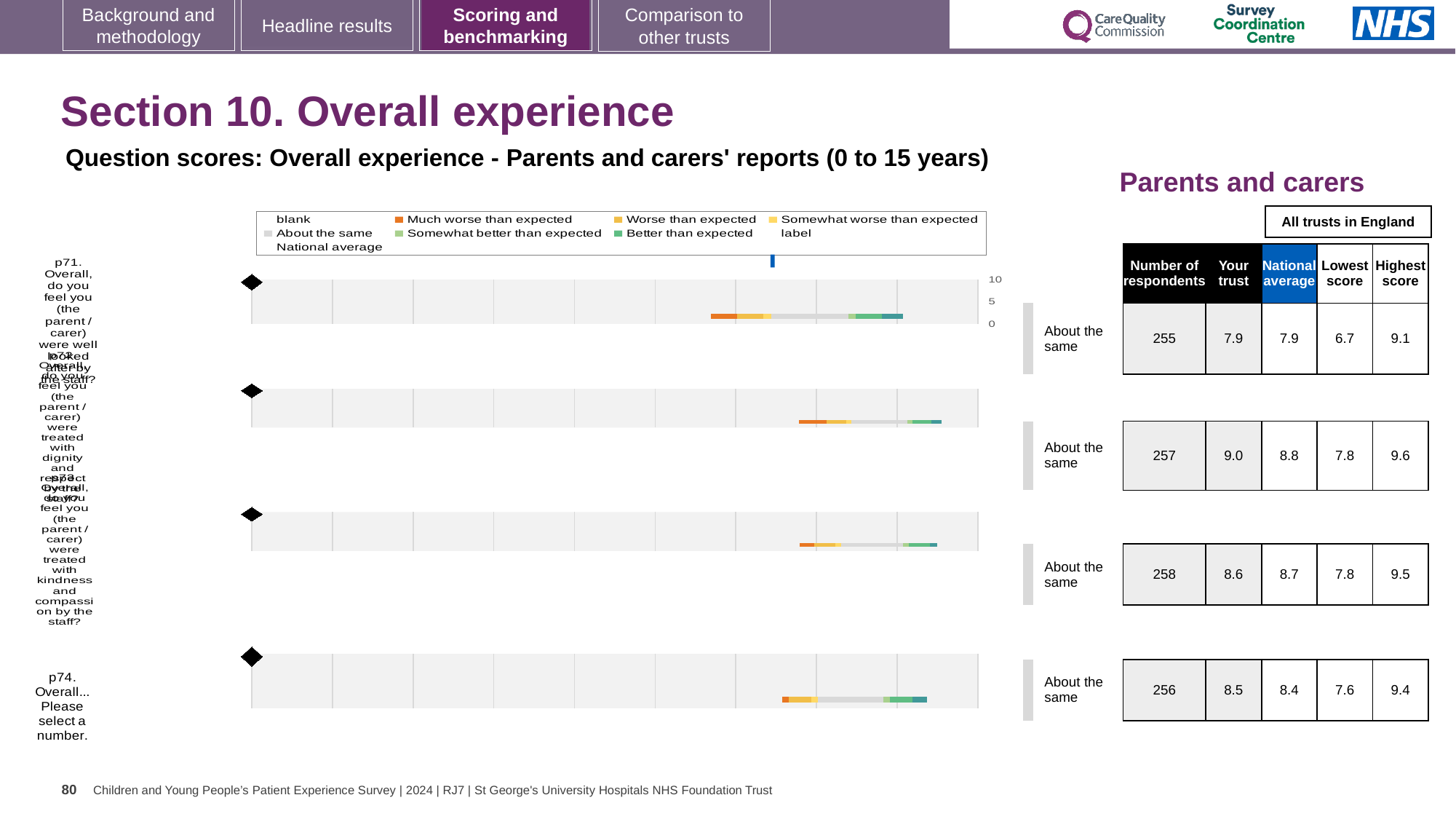
What is the highest score across all trusts in England for p74 (the bottom row)? 9.4 How many respondents are listed for p73 (the third row)? 258 What is the lowest score across all trusts in England for p71 (the first row)? 6.7 What is the 'Your trust' score for p71 (the first row of the chart)? 7.9 Which question has the highest 'Your trust' score? p72 What is the national average score for p72 (the second row)? 8.8 For p73, what is the difference between the national average and the 'Your trust' score? 0.1 What kind of chart is used to show the question scores? Bar chart What benchmark category is shown for p74 (the bottom row)? About the same For p72, which is larger: the 'Your trust' score or the national average? Your trust How many questions (rows) are plotted on the chart? 4 Which question has the lowest 'Your trust' score? p71